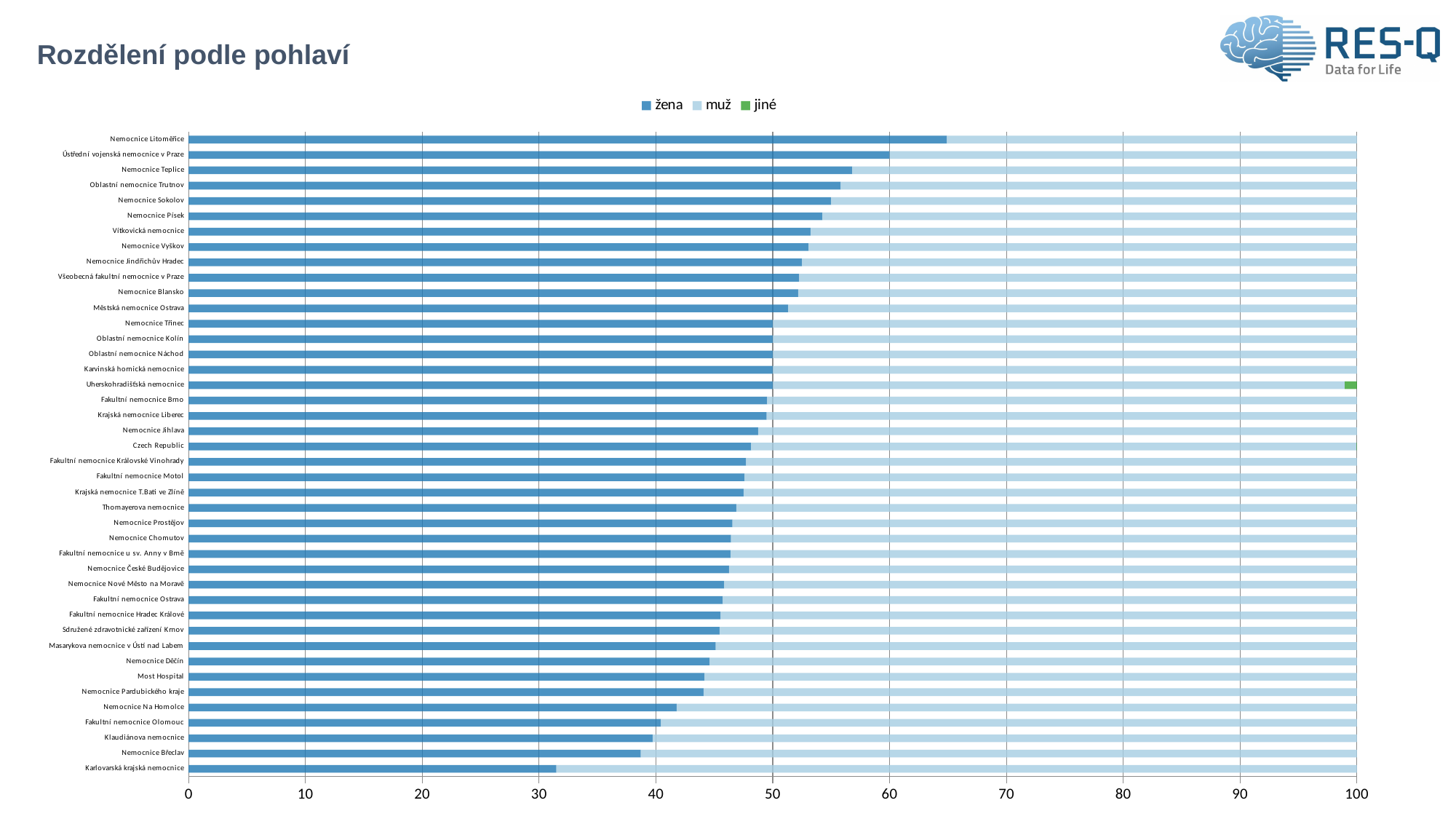
How many hospitals/categories are plotted on the chart? 42 Which category shows a visible green jiné segment at the end of its bar? Uherskohradišťská nemocnice How many series does the legend list? 3 Which has a larger žena value, Nemocnice Litoměřice or Karlovarská krajská nemocnice? Nemocnice Litoměřice What is the title of the chart? Rozdělení podle pohlaví Which category has the lowest value for žena? Karlovarská krajská nemocnice Which category has the highest value for žena? Nemocnice Litoměřice Is the žena value for Nemocnice Litoměřice greater or less than 60? greater Is the žena value for Nemocnice Teplice greater or less than 50? greater What are the series names listed in the legend? žena, muž, jiné Is the žena value for Karlovarská krajská nemocnice greater or less than 40? less What kind of chart is shown on the slide? bar chart